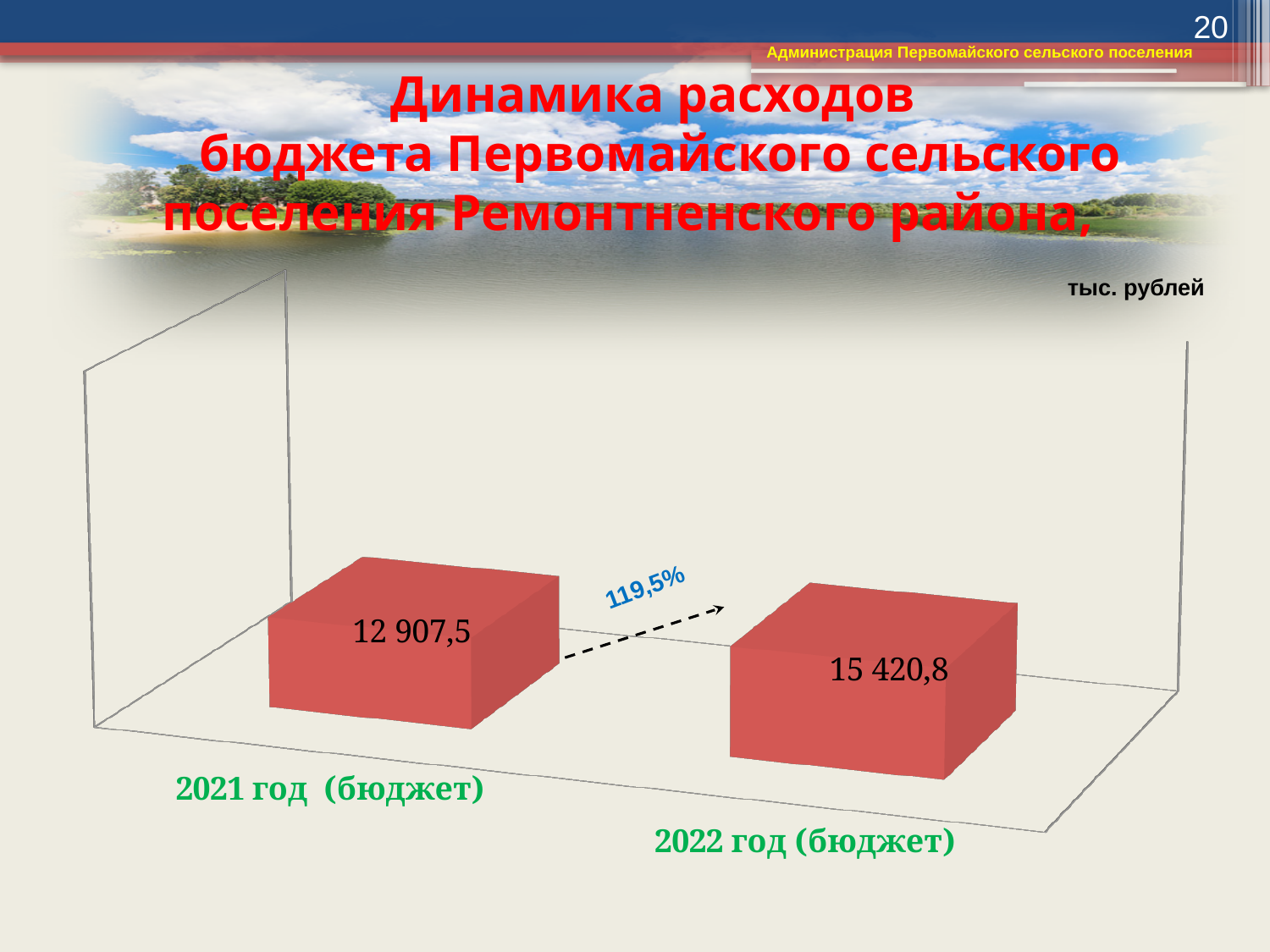
What is the difference between the 2022 год (бюджет) value and the 2021 год (бюджет) value? 2 513,3 Which year has the lower budget expenditure value? 2021 год (бюджет) In what units are the chart values given? тыс. рублей How many categories (years) are shown in the chart? 2 Which year has the higher budget expenditure value? 2022 год (бюджет) What is the value for 2021 год (бюджет)? 12 907,5 Is the value for 2022 год (бюджет) larger or smaller than the value for 2021 год (бюджет)? larger What percentage is shown on the arrow between the two bars? 119,5% Do the values rise or fall from 2021 to 2022? rise What is the value for 2022 год (бюджет)? 15 420,8 What kind of chart is shown on the slide? bar chart